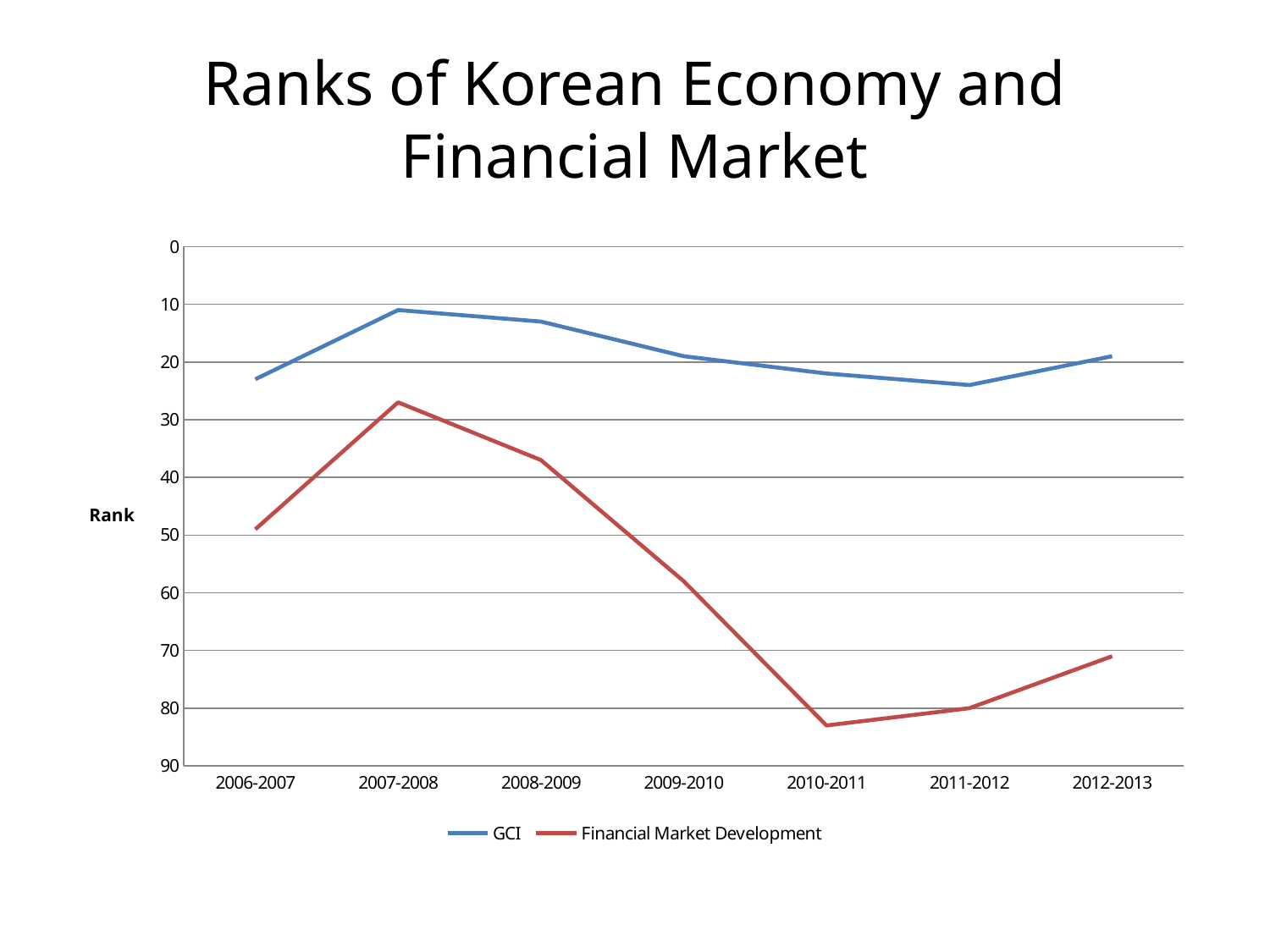
Is the GCI rank for 2006-2007 greater or less than 20? greater Is the Financial Market Development rank for 2010-2011 greater or less than 80? greater In 2009-2010, which series has the larger rank number, GCI or Financial Market Development? Financial Market Development Is the Financial Market Development rank for 2012-2013 greater or less than 60? greater In which period does the GCI series have its smallest rank number? 2007-2008 What is the title of the vertical axis? Rank What kind of chart is shown on the slide? line chart In which period does the Financial Market Development series reach its largest rank number? 2010-2011 How many series does the legend list? 2 How many time periods are plotted along the x axis? 7